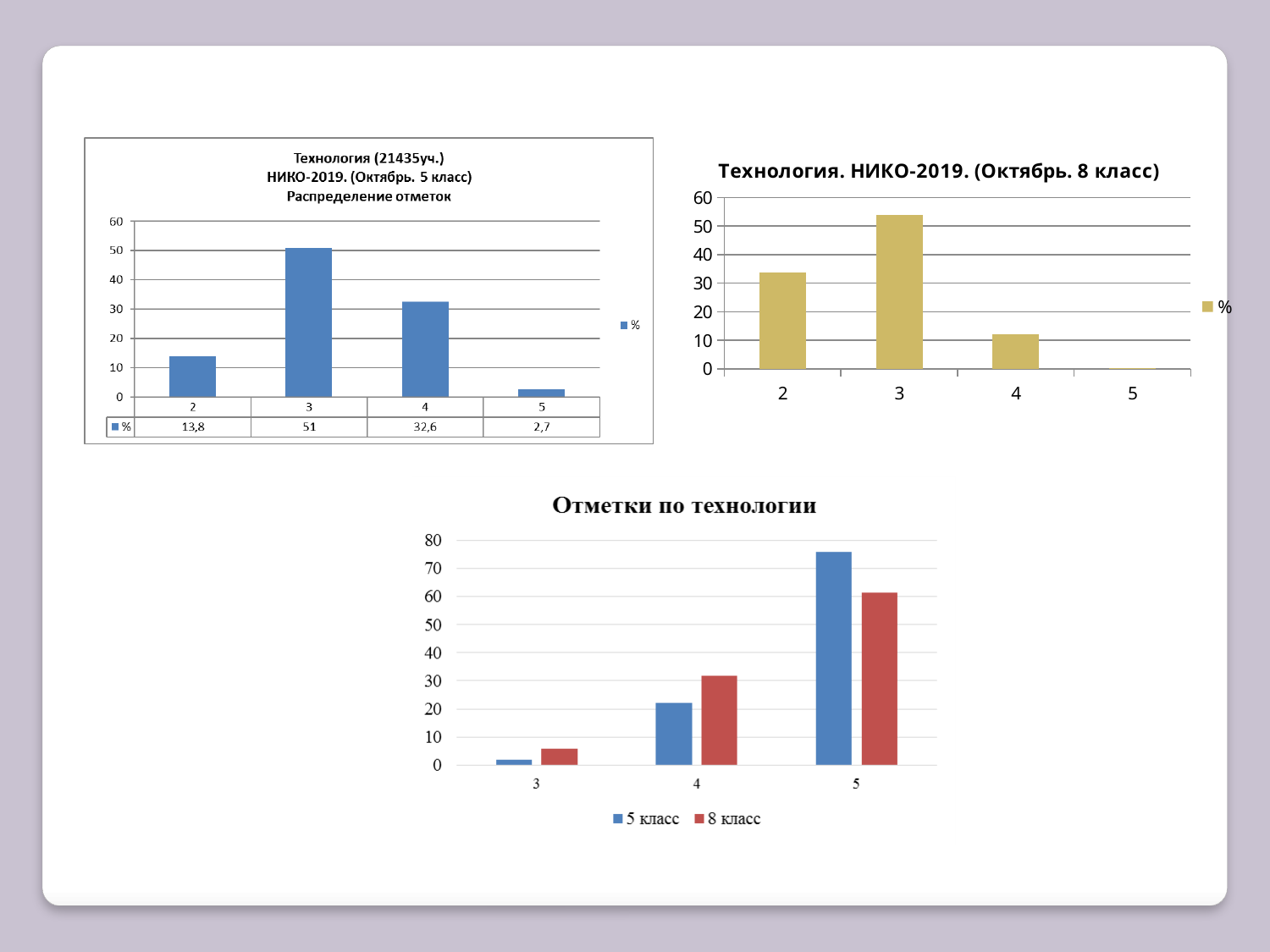
In the top-left chart (Технология, НИКО-2019, 5 класс), what is the value for mark 3? 51 In the top-right chart (Технология. НИКО-2019. Октябрь. 8 класс), is the value for mark 2 greater or less than 30? greater In the bottom chart (Отметки по технологии), which series has the larger value for mark 5, 5 класс or 8 класс? 5 класс In the top-left chart (Технология, НИКО-2019, 5 класс), how many marks are shown on the x axis? 4 In the top-right chart (Технология. НИКО-2019. Октябрь. 8 класс), is the value for mark 4 greater or less than 20? less In the top-left chart (Технология, НИКО-2019, 5 класс), what is the difference between the values for mark 4 and mark 5? 29,9 In the bottom chart (Отметки по технологии), how many series does the legend list? 2 In the top-left chart (Технология, НИКО-2019, 5 класс), which mark has the lowest percentage? 5 What kind of chart is the bottom chart (Отметки по технологии)? bar chart In the top-left chart (Технология, НИКО-2019, 5 класс), what is the value for mark 2? 13,8 In the top-right chart (Технология. НИКО-2019. Октябрь. 8 класс), which mark has the highest bar? 3